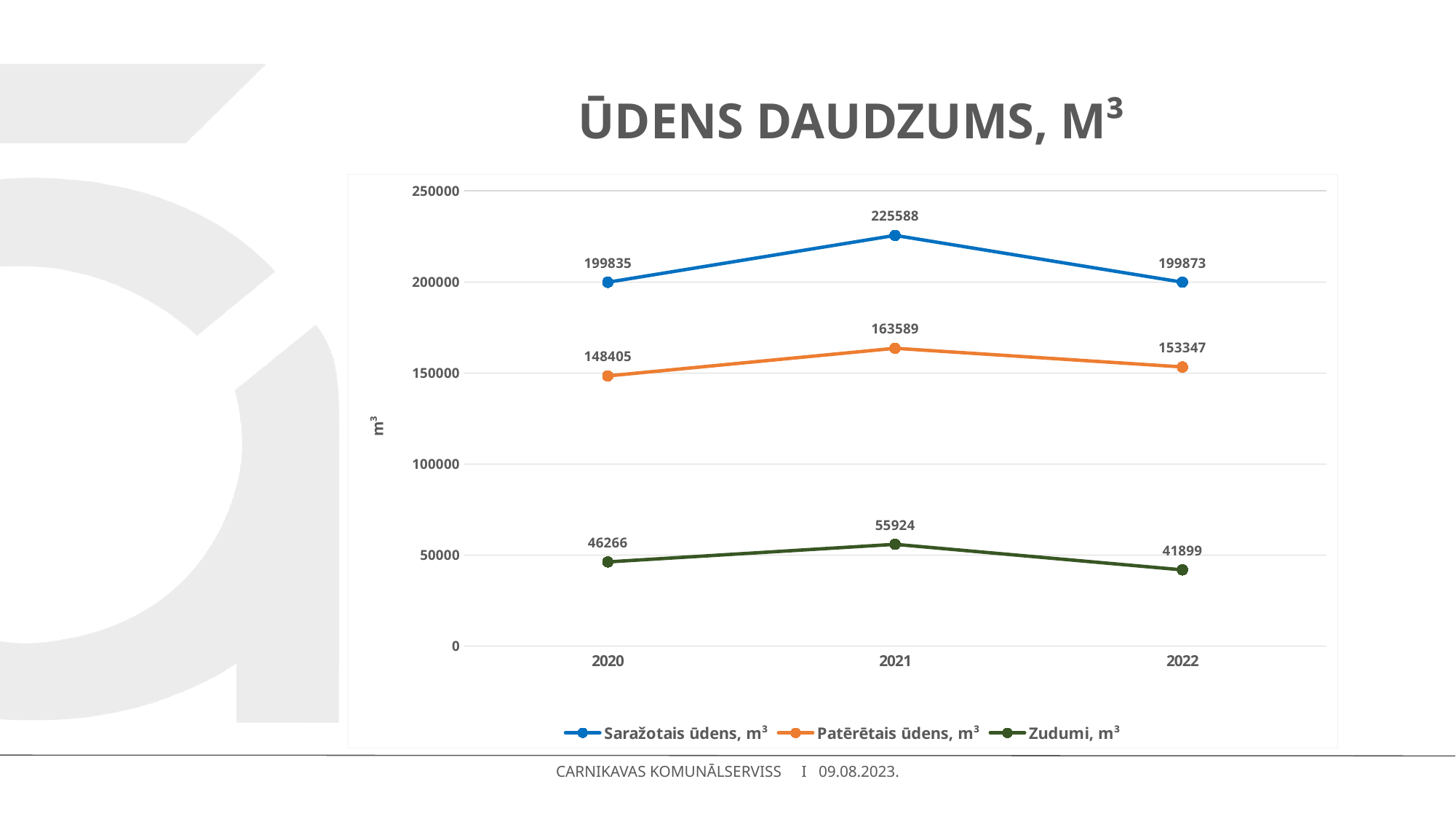
Is the value for Patērētais ūdens, m³ in 2021 greater or less than 150000? greater What is the title of the chart? ŪDENS DAUDZUMS, M³ In which year is Patērētais ūdens, m³ lowest? 2020 Which is larger: Zudumi, m³ in 2020 or in 2022? 2020 In which year is Zudumi, m³ highest? 2021 What is the value of Zudumi, m³ in 2022? 41899 How many years are shown on the x axis? 3 How many series does the legend list? 3 What is the value of Saražotais ūdens, m³ in 2021? 225588 What is the value of Patērētais ūdens, m³ in 2020? 148405 What kind of chart is shown on the slide? line chart What is the difference between Saražotais ūdens, m³ and Patērētais ūdens, m³ in 2022? 46526